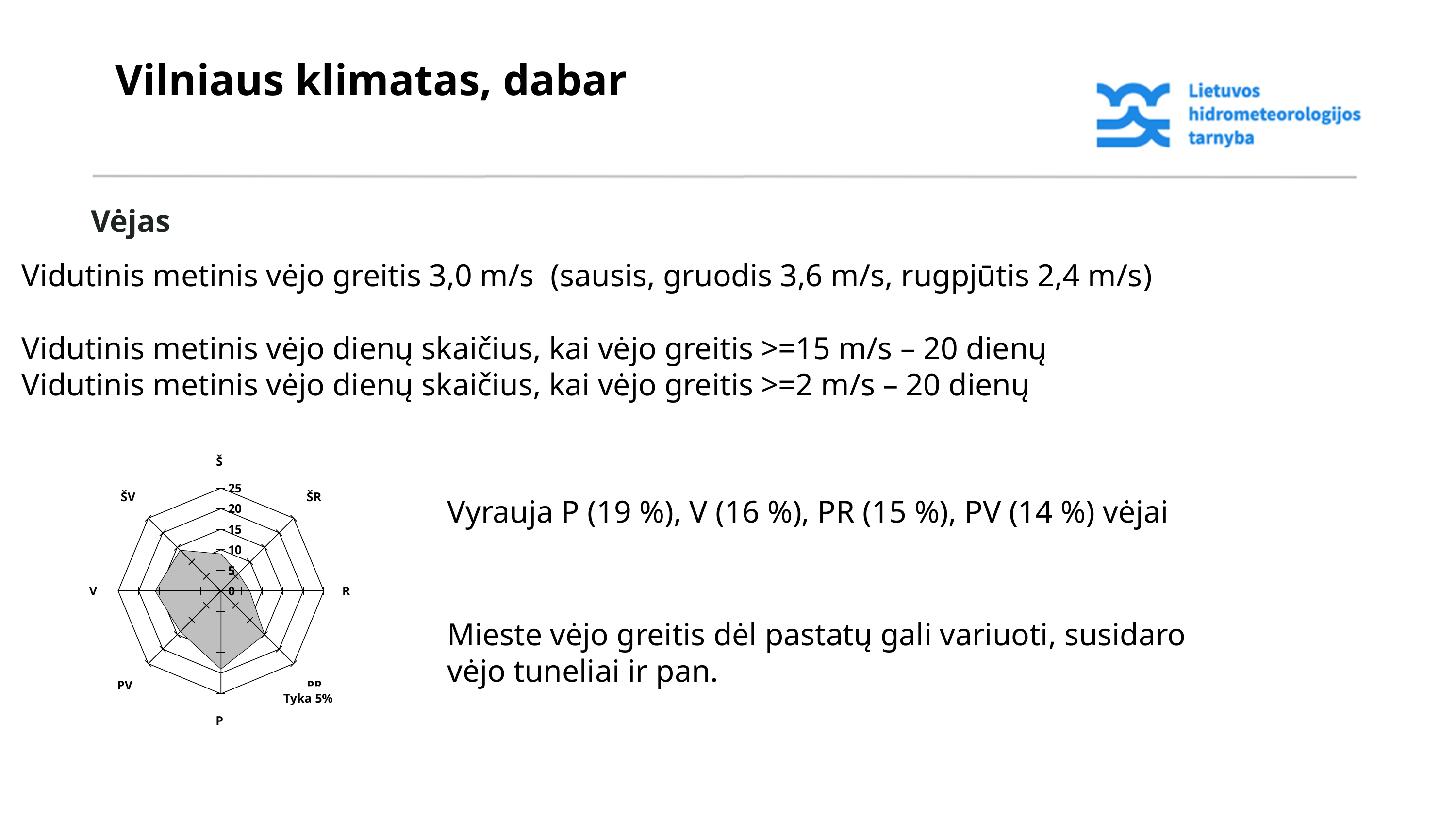
Is the value for R on the radar chart greater or less than 10? less How many wind directions (categories) does the radar chart have? 8 Is the value for ŠR on the radar chart greater or less than 10? less What kind of chart is shown on the slide? radar chart What is the highest value shown on the radar chart's axis scale? 25 What calm-wind (Tyka) share is noted next to the radar chart? 5% Is the value for P on the radar chart greater or less than 15? greater Which wind direction has the highest value on the radar chart? P Which has the larger value on the radar chart, V or ŠR? V Which has the larger value on the radar chart, P or R? P